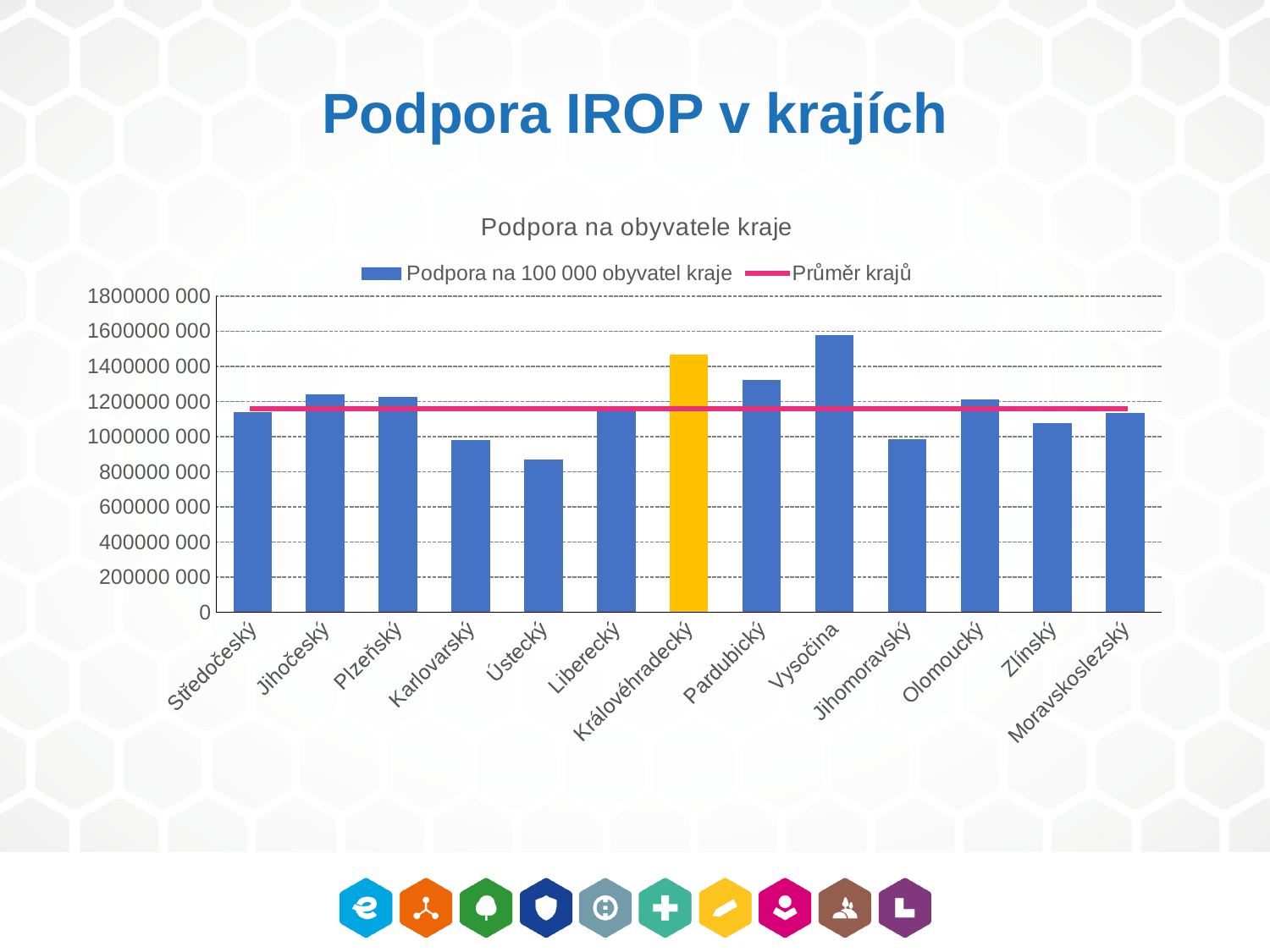
What type of chart is shown on the slide? combination bar and line chart Is the value for Vysočina greater or less than 1400000 000? greater Which region has the highest value for Podpora na 100 000 obyvatel kraje? Vysočina Which has the larger value, Jihočeský or Karlovarský? Jihočeský Is the value for Ústecký greater or less than 1000000 000? less Which region's bar is highlighted in orange instead of blue? Královéhradecký Which has the larger value, Vysočina or Královéhradecký? Vysočina How many series does the chart legend list? 2 How many regions (categories) are shown on the x axis of the chart? 13 Which region has the lowest value for Podpora na 100 000 obyvatel kraje? Ústecký Is the value for Pardubický greater or less than 1200000 000? greater